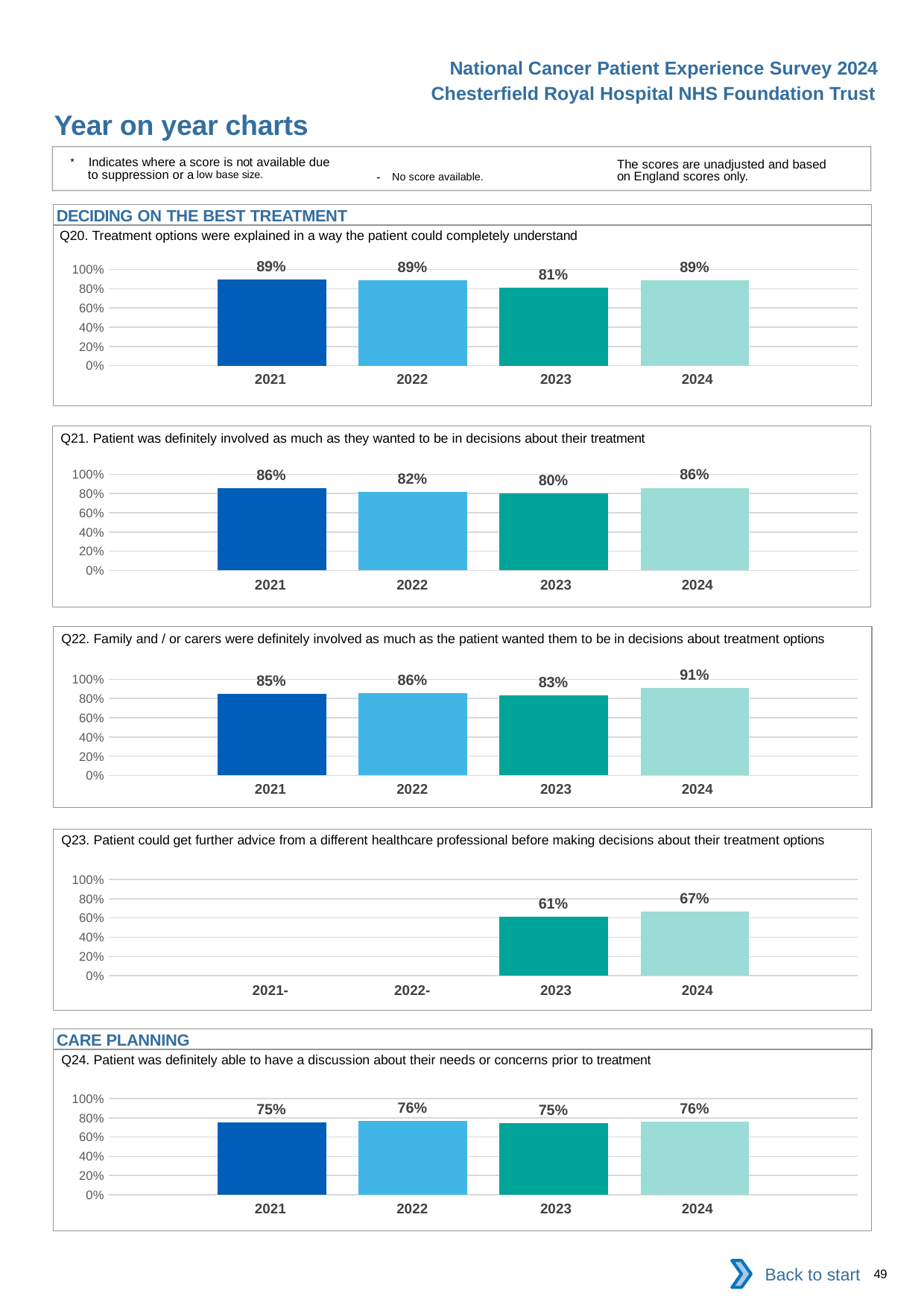
In the Q20 chart, is the value for 2023 greater or less than 80%? greater In the Q21 chart, what is the difference between the 2021 and 2022 values? 4% In the Q24 chart, is the value for 2022 larger or smaller than the value for 2023? larger In the Q20 chart, what is the value for 2023? 81% What kind of chart is the Q20 chart? bar chart In the Q22 chart, which year has the highest value? 2024 In the Q21 chart, which year has the lowest value? 2023 In the Q24 chart, how many years are shown on the x axis? 4 In the Q23 chart, how many years have a bar plotted? 2 What is the section heading above the Q24 chart? CARE PLANNING In the Q22 chart, what is the difference between the 2024 and 2023 values? 8% In the Q23 chart, what is the value for 2024? 67%